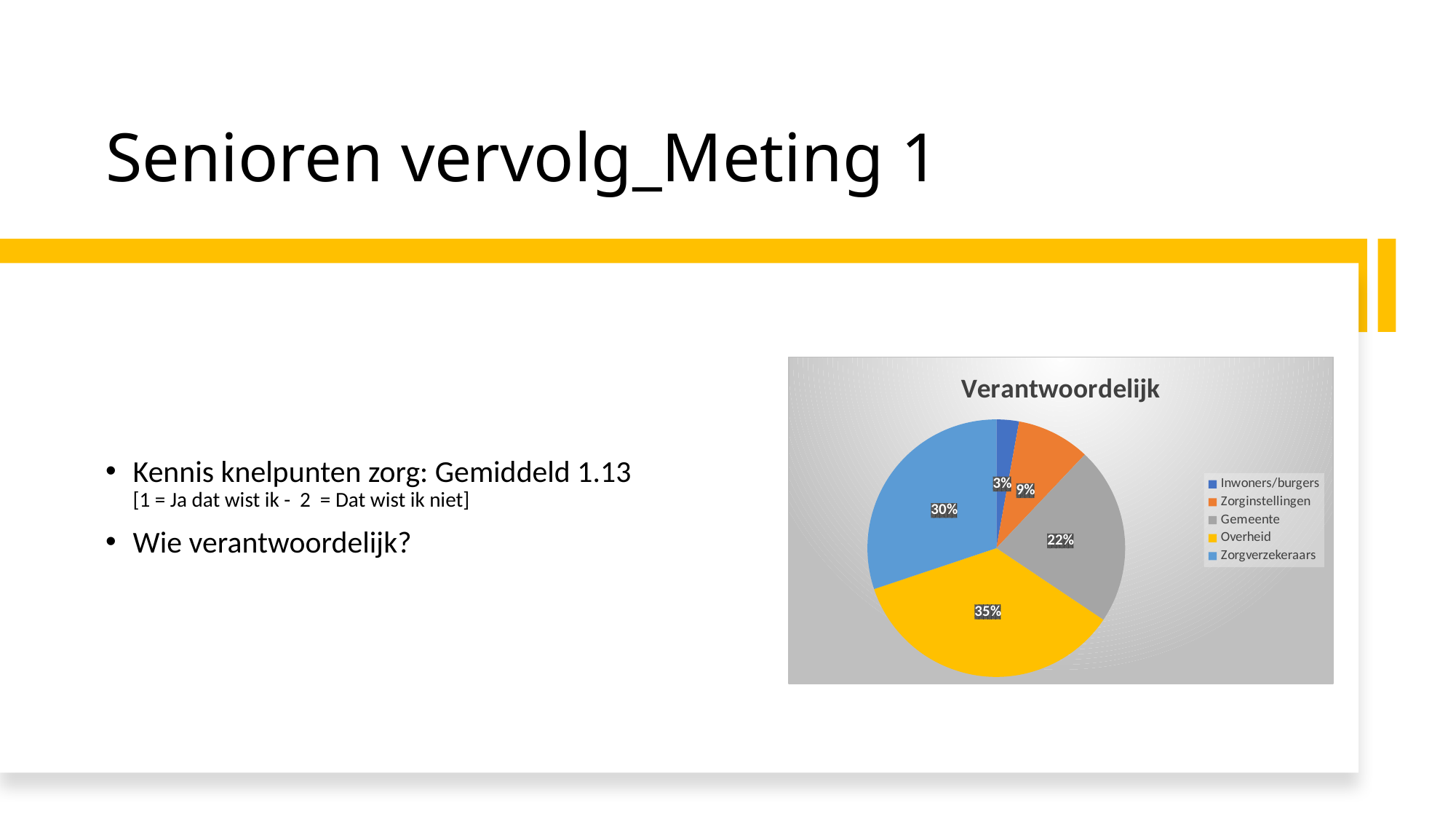
How many categories does the pie chart show? 5 What share of the pie does Inwoners/burgers have? 3% What share of the pie does Gemeente have? 22% What is the title of the chart? Verantwoordelijk What share of the pie does Zorginstellingen have? 9% Which is larger, the share for Zorgverzekeraars or the share for Gemeente? Zorgverzekeraars What is the difference between the shares of Overheid and Gemeente? 13% Which category has the largest slice of the pie? Overheid Which category has the smallest slice of the pie? Inwoners/burgers What kind of chart is shown on the slide? pie chart